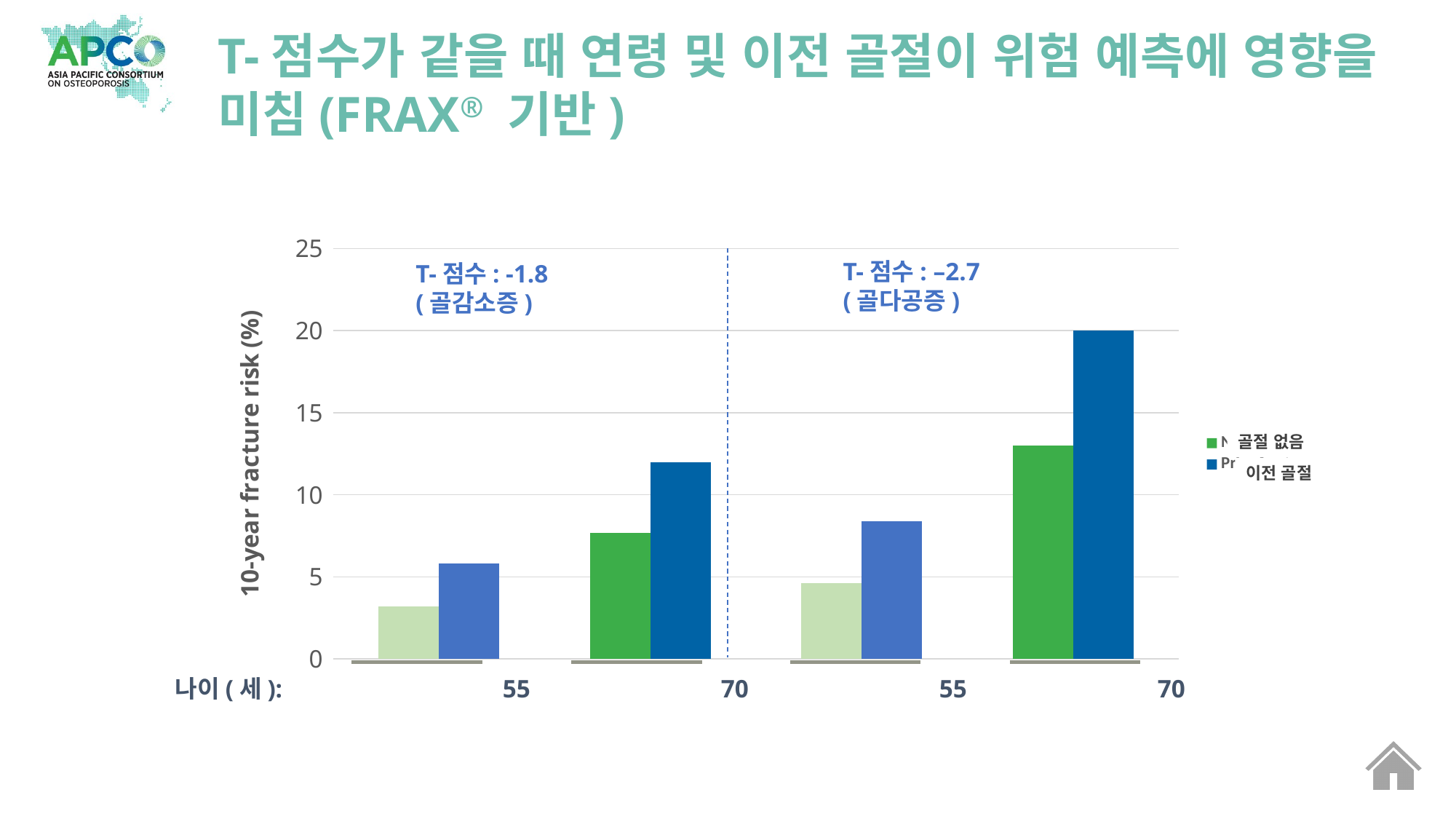
Which two T-scores are labelled on the chart? -1.8 and -2.7 Which bar is the lowest on the chart? 골절 없음 at age 55 in the T-점수 -1.8 (골감소증) group At age 70 in the T-점수 -2.7 (골다공증) group, which is larger: 골절 없음 or 이전 골절? 이전 골절 What kind of chart is shown on the slide? bar chart What is the label of the vertical axis of the chart? 10-year fracture risk (%) Which bar is the highest on the chart? 이전 골절 at age 70 in the T-점수 -2.7 (골다공증) group Within each T-score group, does the fracture risk rise or fall from age 55 to age 70? rise Is the value for 골절 없음 at age 55 in the T-점수 -1.8 (골감소증) group greater or less than 5? less Is the value for 골절 없음 at age 70 in the T-점수 -2.7 (골다공증) group greater or less than 10? greater Is the value for 이전 골절 at age 70 in the T-점수 -1.8 (골감소증) group greater or less than 10? greater How many series does the chart legend list? 2